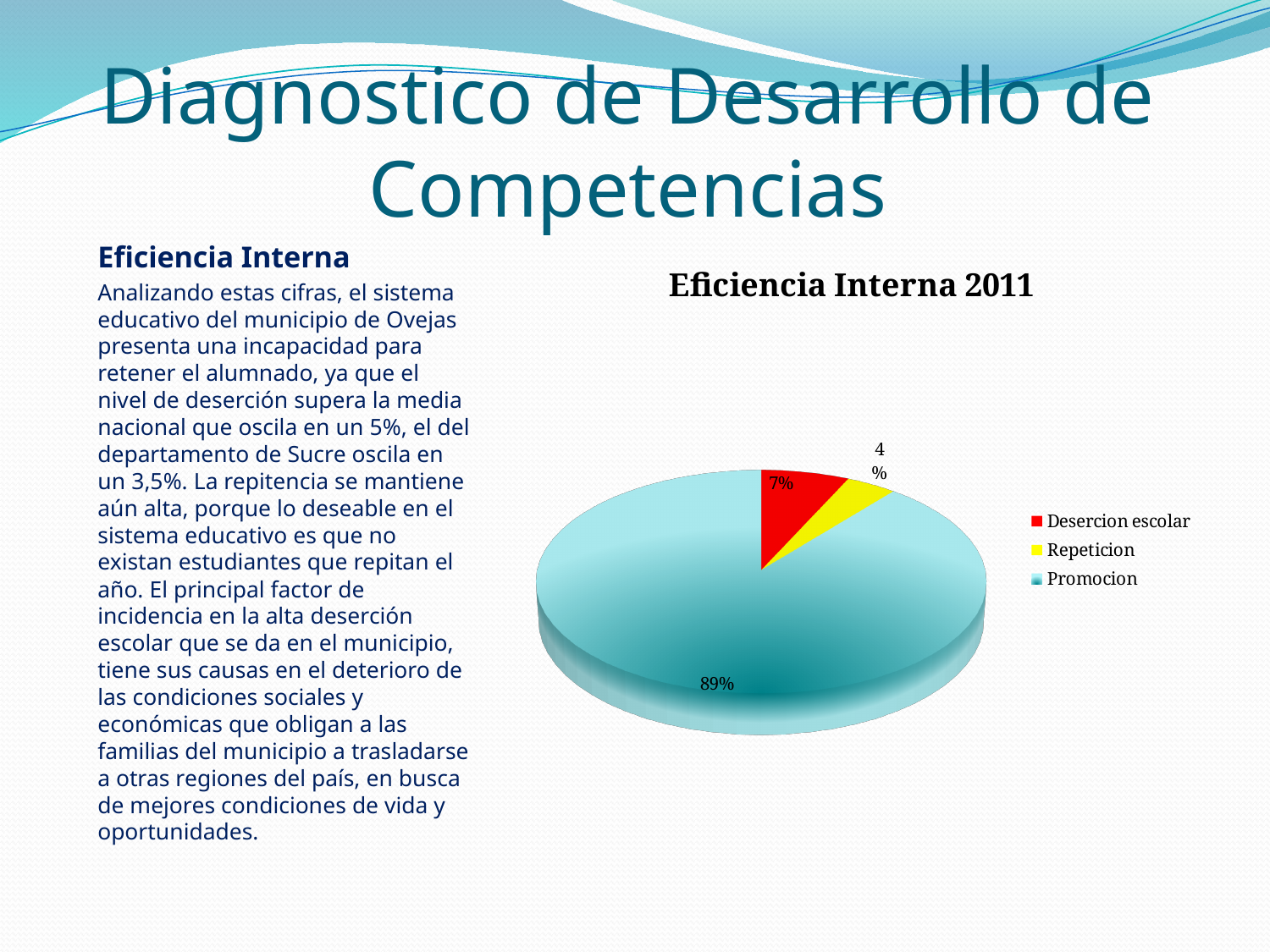
How many categories does the legend list? 3 Which category has the largest share of the pie? Promocion What is the title of the chart? Eficiencia Interna 2011 What colour is the Repeticion slice? yellow What is the combined share of Desercion escolar and Repeticion? 11% Which category has the smallest share of the pie? Repeticion What percentage does the Repeticion slice represent? 4% Which is larger, Desercion escolar or Repeticion? Desercion escolar What percentage does the Promocion slice represent? 89% What percentage does the Desercion escolar slice represent? 7% What type of chart is shown on the slide? pie chart What is the difference between the Promocion share and the Desercion escolar share? 82%